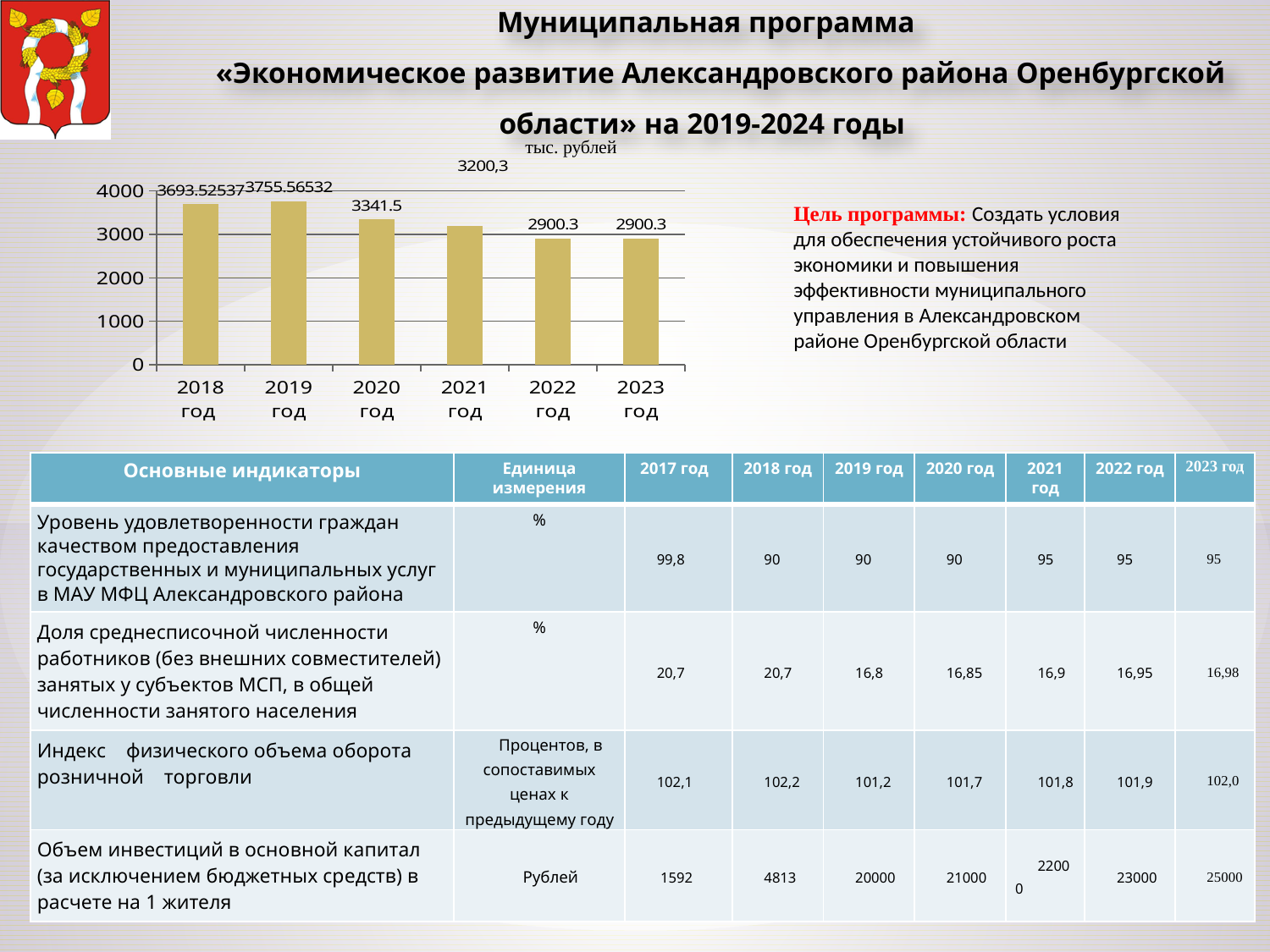
What is the difference between the values for 2020 год and 2022 год in the chart? 441.2 Which is larger in the chart, the value for 2020 год or the value for 2022 год? 2020 год What unit is stated above the chart? тыс. рублей What is the value for 2022 год in the chart? 2900.3 Which year has the highest value in the chart? 2019 год What is the value for 2021 год in the chart? 3200,3 From 2019 год to 2023 год, do the values in the chart rise or fall? fall What is the value for 2020 год in the chart? 3341.5 Is the value for 2021 год greater or less than 3000? greater What type of chart is shown on the slide? bar chart How many bars (years) does the chart show? 6 What is the value for 2019 год in the chart? 3755.56532